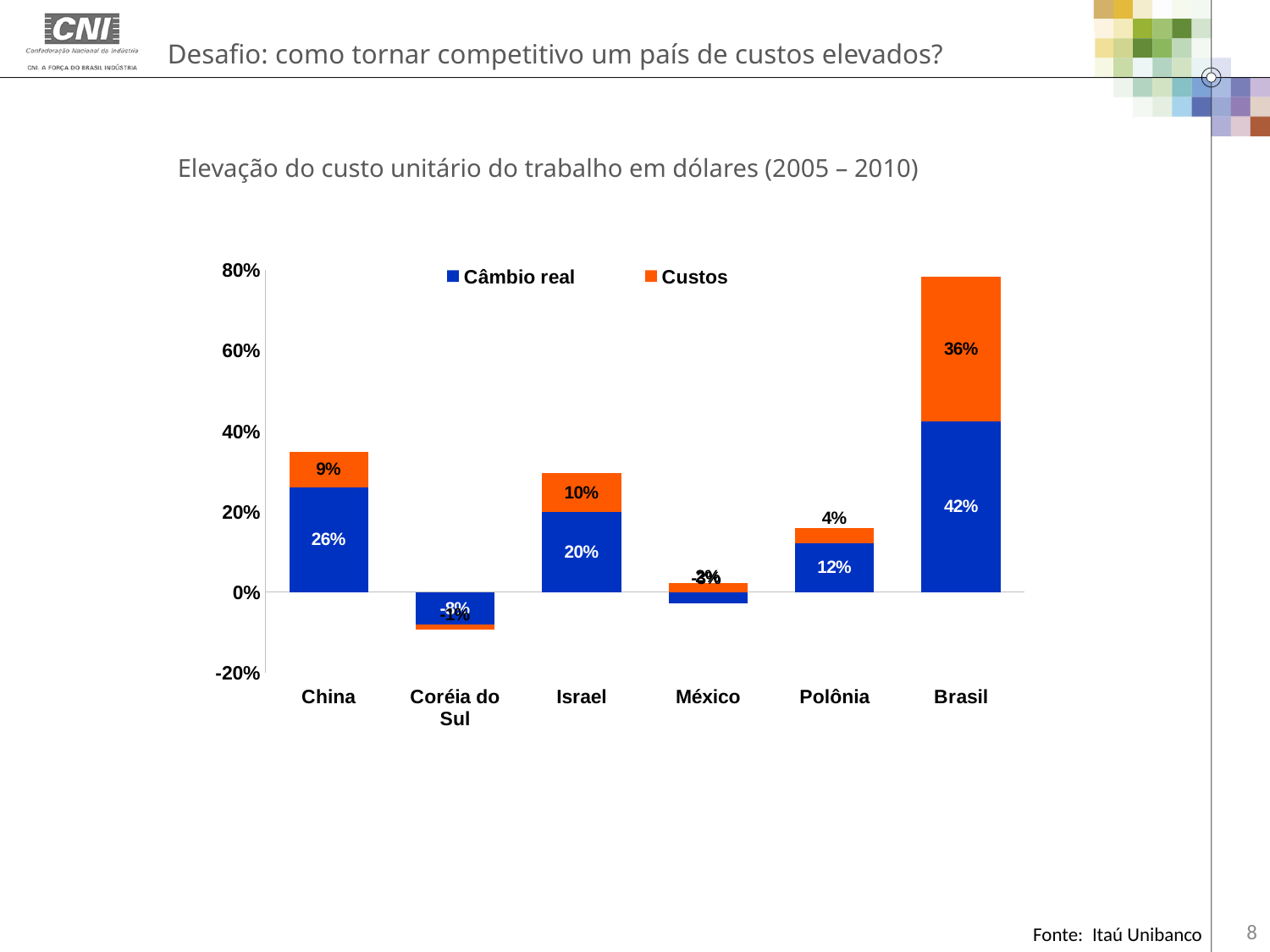
What is the Câmbio real value for Brasil? 42% What kind of chart is shown on the slide? Stacked bar chart What is the total of the stacked bar for Brasil? 78% Which country has the highest Câmbio real value? Brasil What are the two entries in the chart legend? Câmbio real and Custos Which is larger, the Câmbio real value for China or for Israel? China How many countries are shown on the x axis? 6 What is the Custos value for Israel? 10% How many series does the legend list? 2 What is the Câmbio real value for China? 26% What is the Custos value for Brasil? 36% What is the difference between the Custos value for Brasil and the Custos value for Polônia? 32%